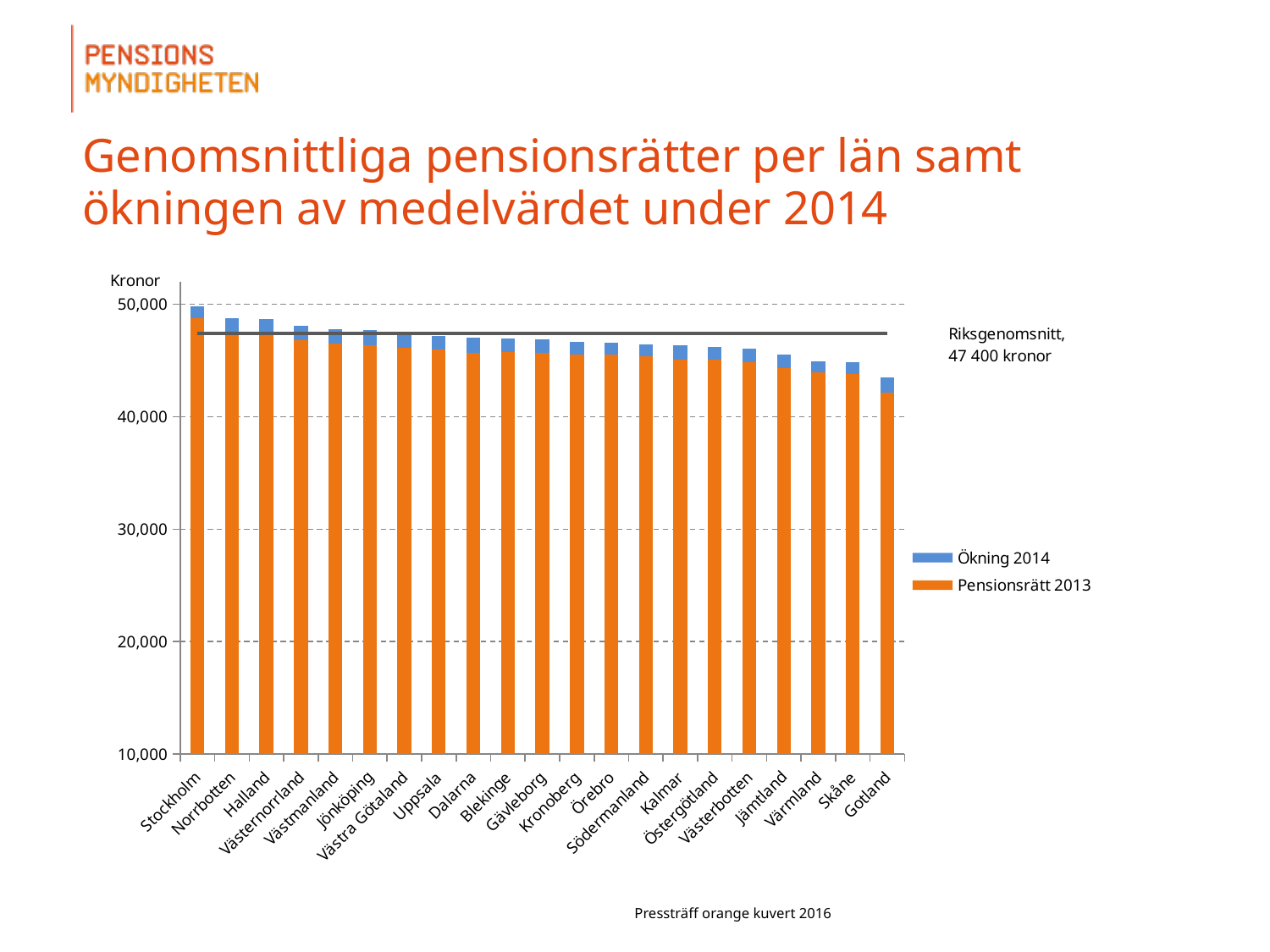
How many counties (län) are shown on the x axis of the chart? 21 How many series does the chart's legend list? 2 Which county has the highest total bar in the chart? Stockholm Do the total bar values rise or fall moving from left to right along the x axis? fall What national average (Riksgenomsnitt) value is marked by the horizontal line in the chart? 47 400 kronor Which has a larger total bar, Norrbotten or Skåne? Norrbotten What kind of chart is shown on the slide? bar chart Is the total value for Stockholm greater or less than 45,000? greater Which county has the lowest total bar in the chart? Gotland Is the total value for Gotland greater or less than 40,000? greater What are the two series named in the chart's legend? Ökning 2014 and Pensionsrätt 2013 Is the total value for Gotland greater or less than 45,000? less